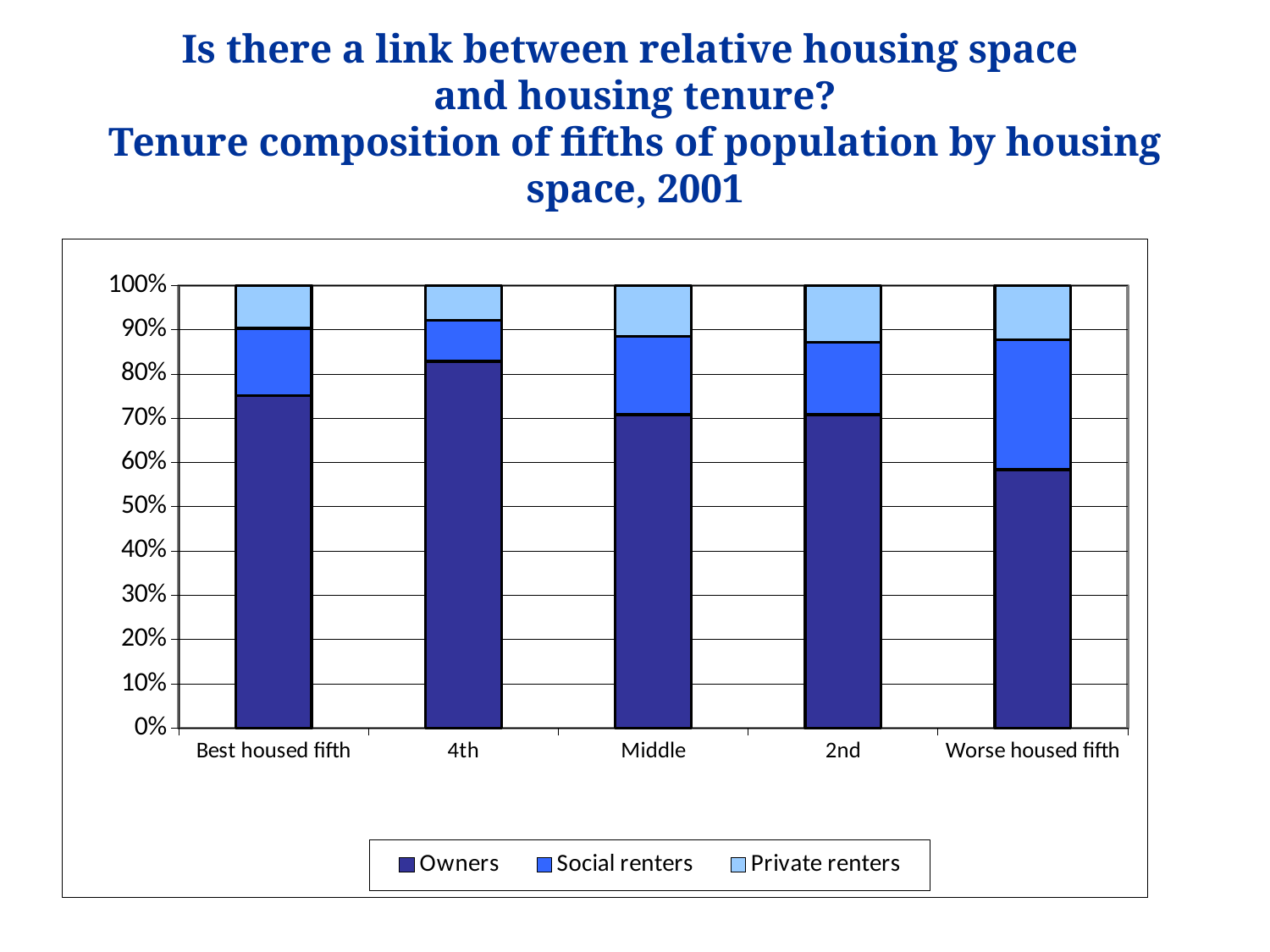
Which is larger, the Owners share for 4th or the Owners share for Worse housed fifth? 4th What is the total of the stacked bar for Middle? 100% Which category has the largest Social renters share? Worse housed fifth Is the Owners value for Worse housed fifth greater or less than 70%? less What kind of chart is shown on the slide? bar chart Which category has the largest Owners share? 4th Which category has the smallest Owners share? Worse housed fifth Which category has the smallest Social renters share? 4th Is the Owners value for Best housed fifth greater or less than 70%? greater How many categories are shown along the x axis? 5 What are the three series named in the legend? Owners, Social renters, Private renters How many series does the legend list? 3